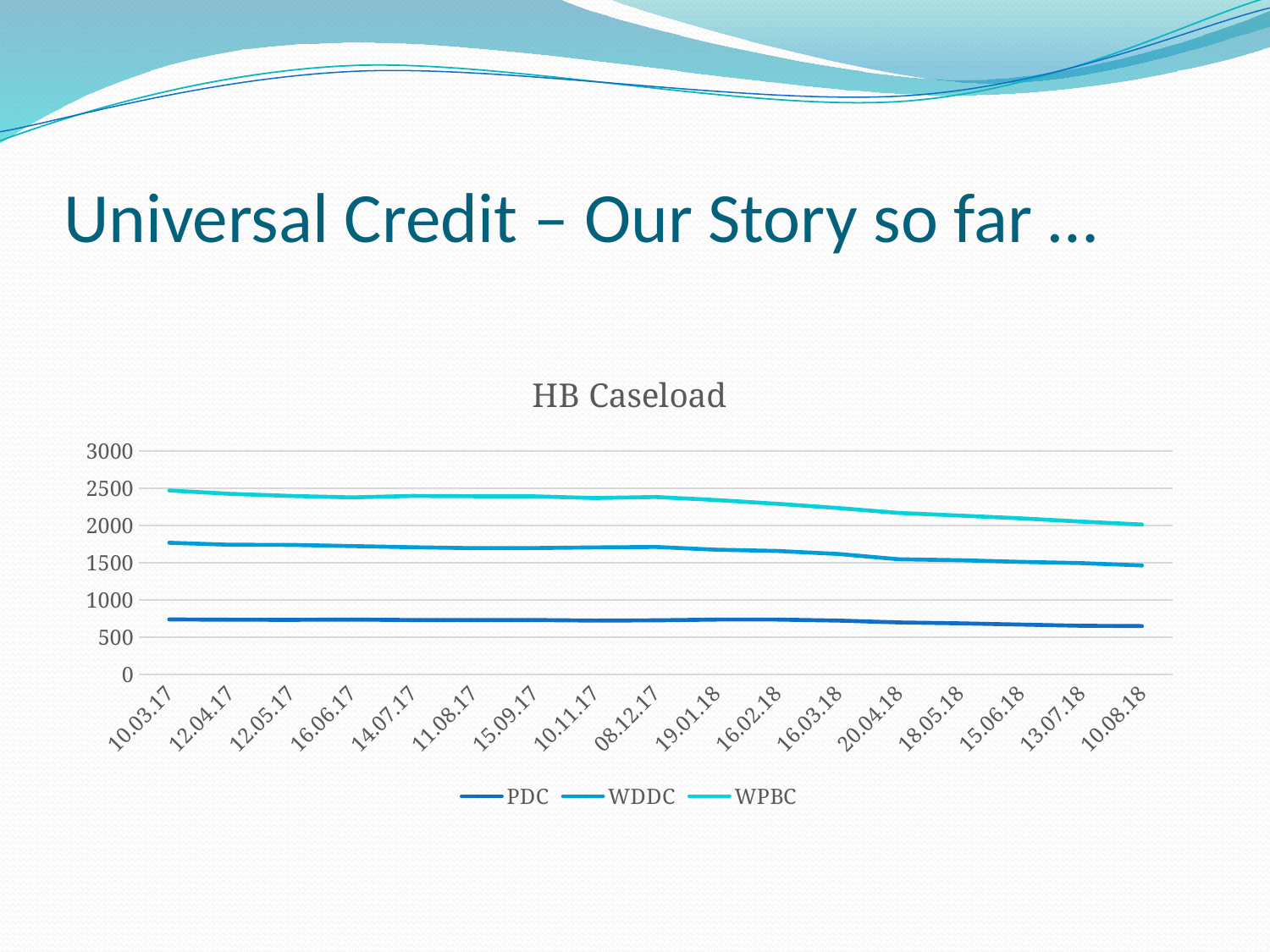
How many dates are shown on the x axis? 17 How many series does the legend list? 3 Which series has the lowest values throughout the chart? PDC At 10.08.18, which is larger, the WDDC value or the PDC value? WDDC What is the title of the chart? HB Caseload Does the WPBC series rise or fall from 10.03.17 to 10.08.18? fall Is the value for WPBC at 10.03.17 greater or less than 2000? greater Is the value for PDC at 10.03.17 greater or less than 1000? less Which series has the highest values throughout the chart? WPBC What kind of chart is shown on the slide? line chart Is the value for WDDC at 10.03.17 greater or less than 1500? greater Which series are listed in the legend? PDC, WDDC, WPBC